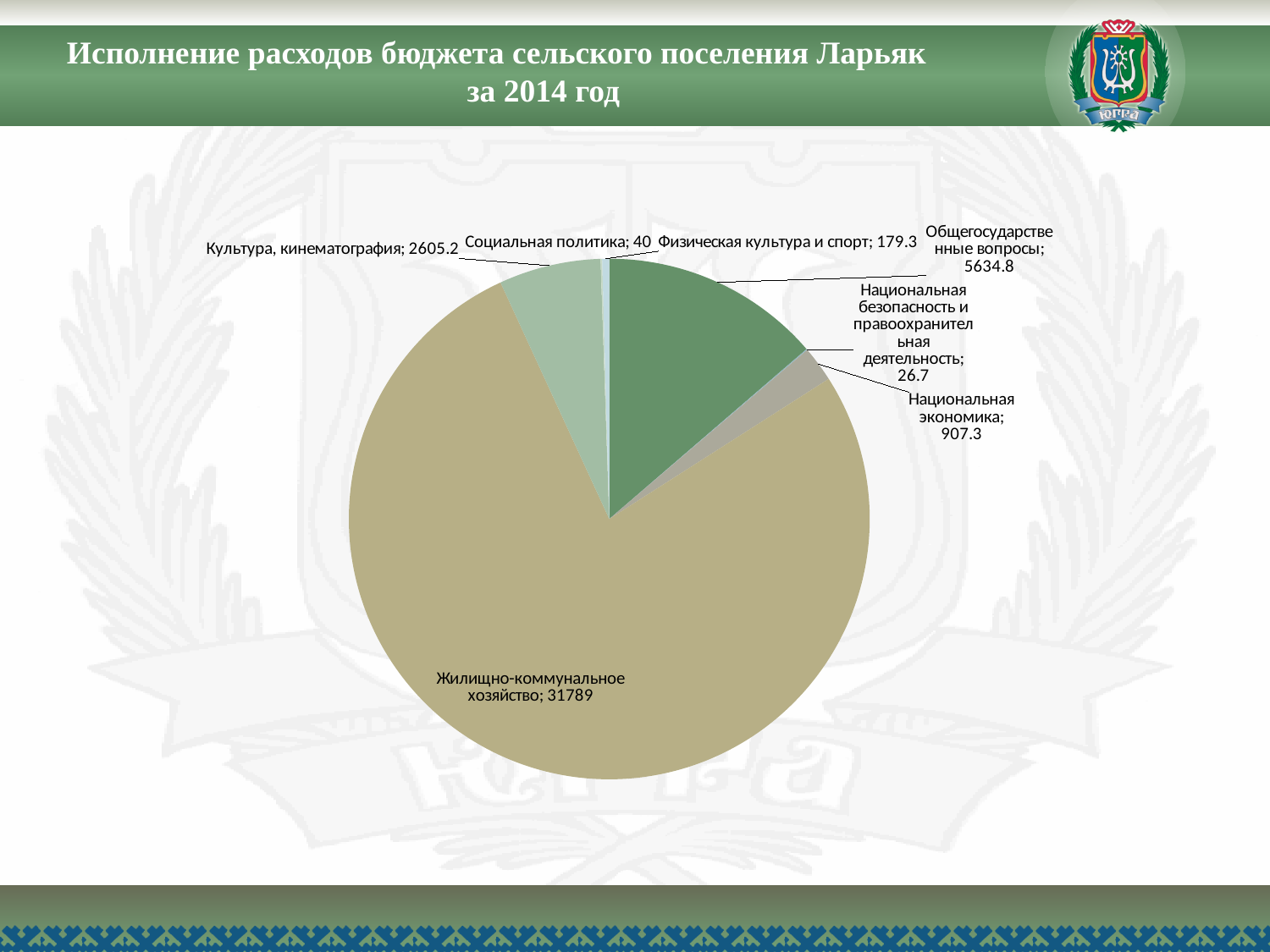
What is the title of the slide? Исполнение расходов бюджета сельского поселения Ларьяк за 2014 год Which category has the largest slice of the pie? Жилищно-коммунальное хозяйство What is the value for Жилищно-коммунальное хозяйство? 31789 What is the difference between Общегосударственные вопросы and Культура, кинематография? 3029.6 Which category has the smallest value? Национальная безопасность и правоохранительная деятельность How many categories are shown in the pie chart? 7 What is the value for Социальная политика? 40 What is the value for Общегосударственные вопросы? 5634.8 What is the value for Национальная экономика? 907.3 Which is larger: Культура, кинематография or Национальная экономика? Культура, кинематография What is the difference between Национальная экономика and Физическая культура и спорт? 728 What kind of chart is shown on the slide? Pie chart